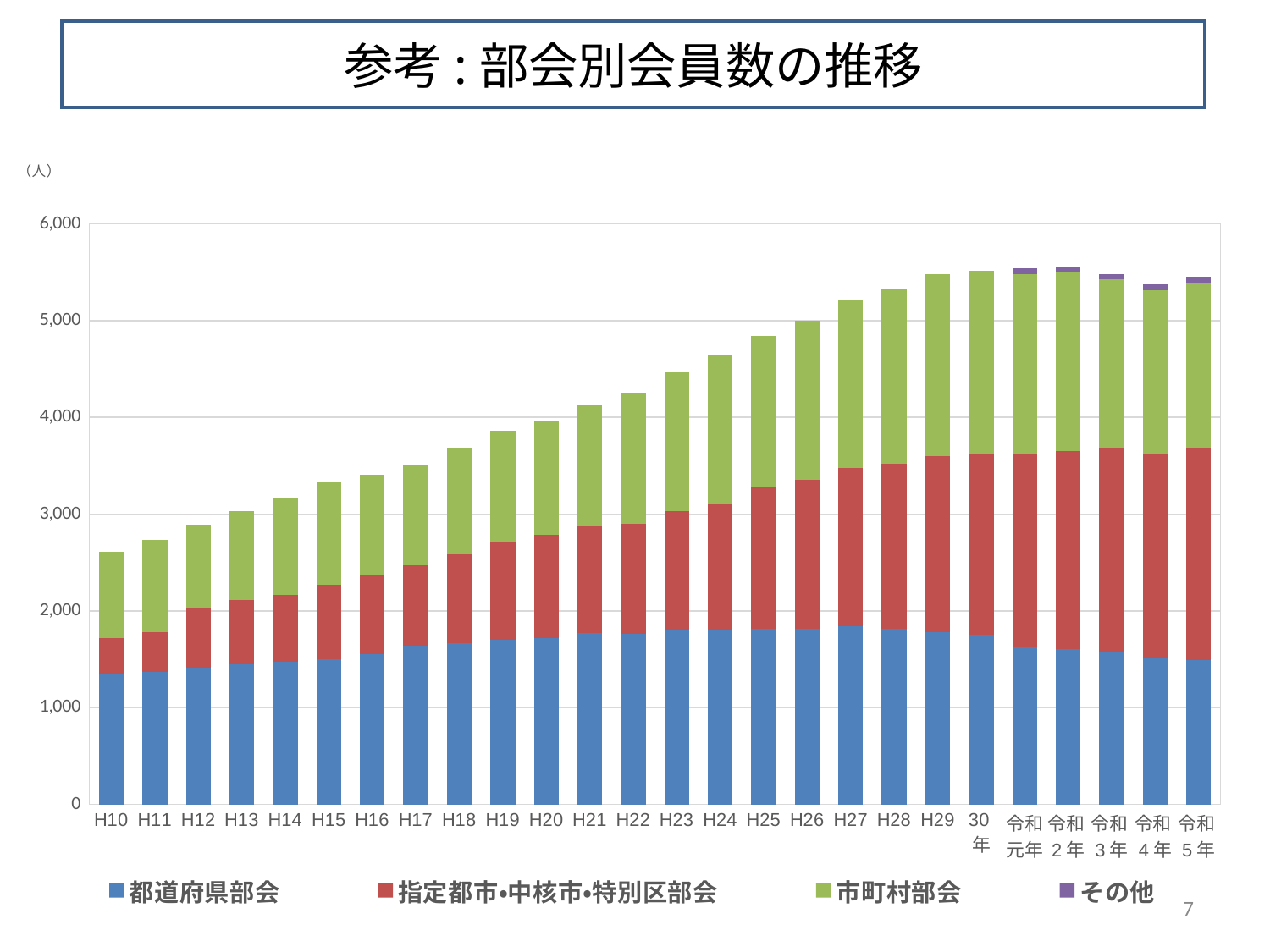
Which series is shown in green in the legend? 市町村部会 Which year has the lowest total number of members? H10 How many series does the legend list? 4 What kind of chart is shown on the slide? Stacked bar chart Which has the larger total, H10 or 令和5年? 令和5年 Is the value of 都道府県部会 for H10 greater or less than 1,000? greater Do the total bar heights generally rise or fall from H10 to H29? rise How many year categories are shown on the x axis? 26 Is the total for H10 greater or less than 3,000? less Is the total for H29 greater or less than 5,000? greater What is the title of the slide's chart? 参考：部会別会員数の推移